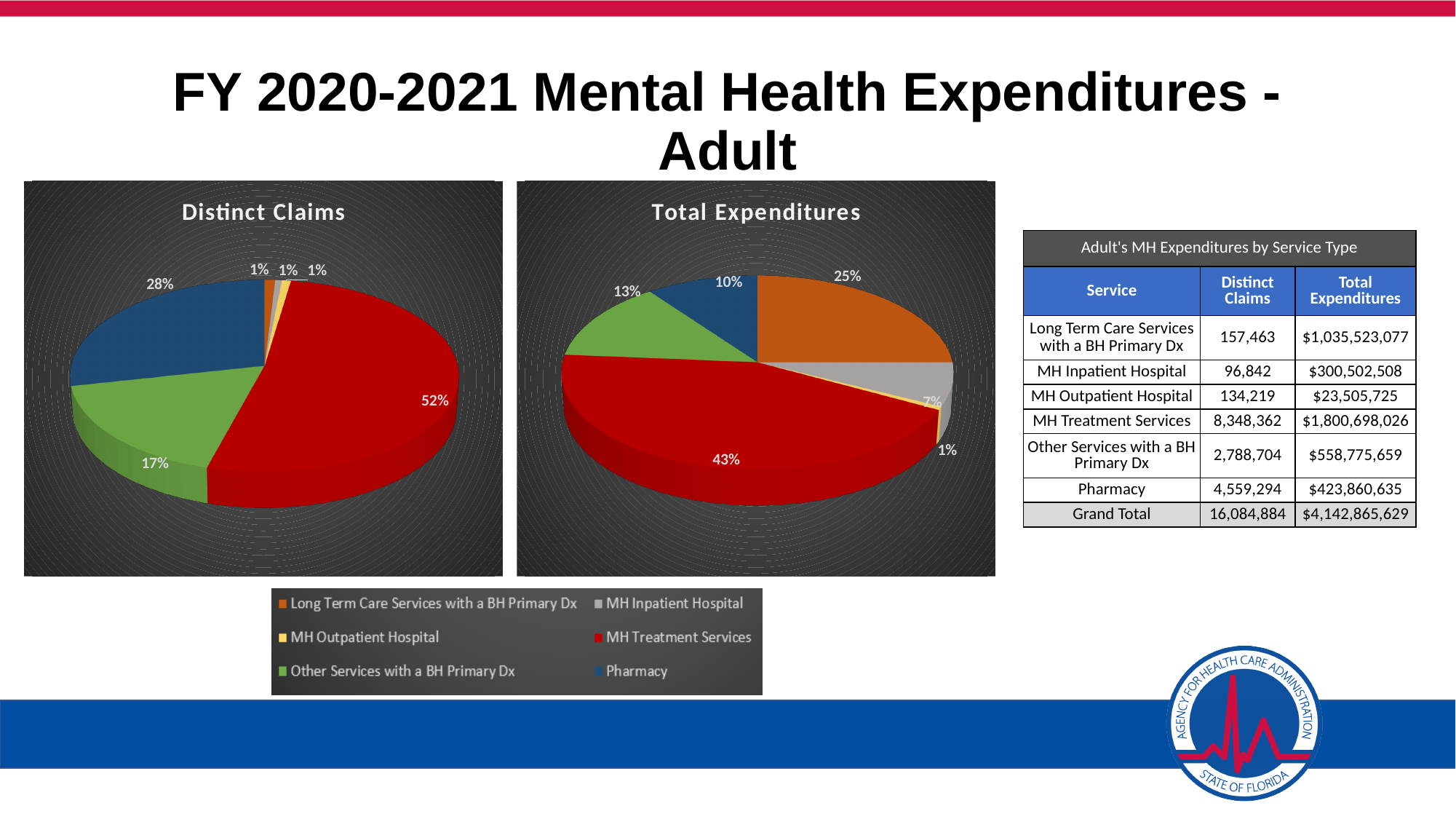
In the "Total Expenditures" chart, which service has the smallest slice? MH Outpatient Hospital What kind of chart is the "Distinct Claims" chart? pie chart In the "Distinct Claims" chart, which service has the largest slice? MH Treatment Services In the "Total Expenditures" chart, what share of the pie does MH Treatment Services (red) take? 43% In the "Distinct Claims" chart, what share of the pie does Pharmacy (blue) take? 28% In the "Total Expenditures" chart, what is the difference in percentage points between the MH Treatment Services slice and the Long Term Care Services with a BH Primary Dx slice? 18 percentage points In the "Distinct Claims" chart, what share of the pie does MH Treatment Services (red) take? 52% In the "Total Expenditures" chart, which slice is larger: Other Services with a BH Primary Dx or Pharmacy? Other Services with a BH Primary Dx How many entries does the shared legend below the pie charts list? 6